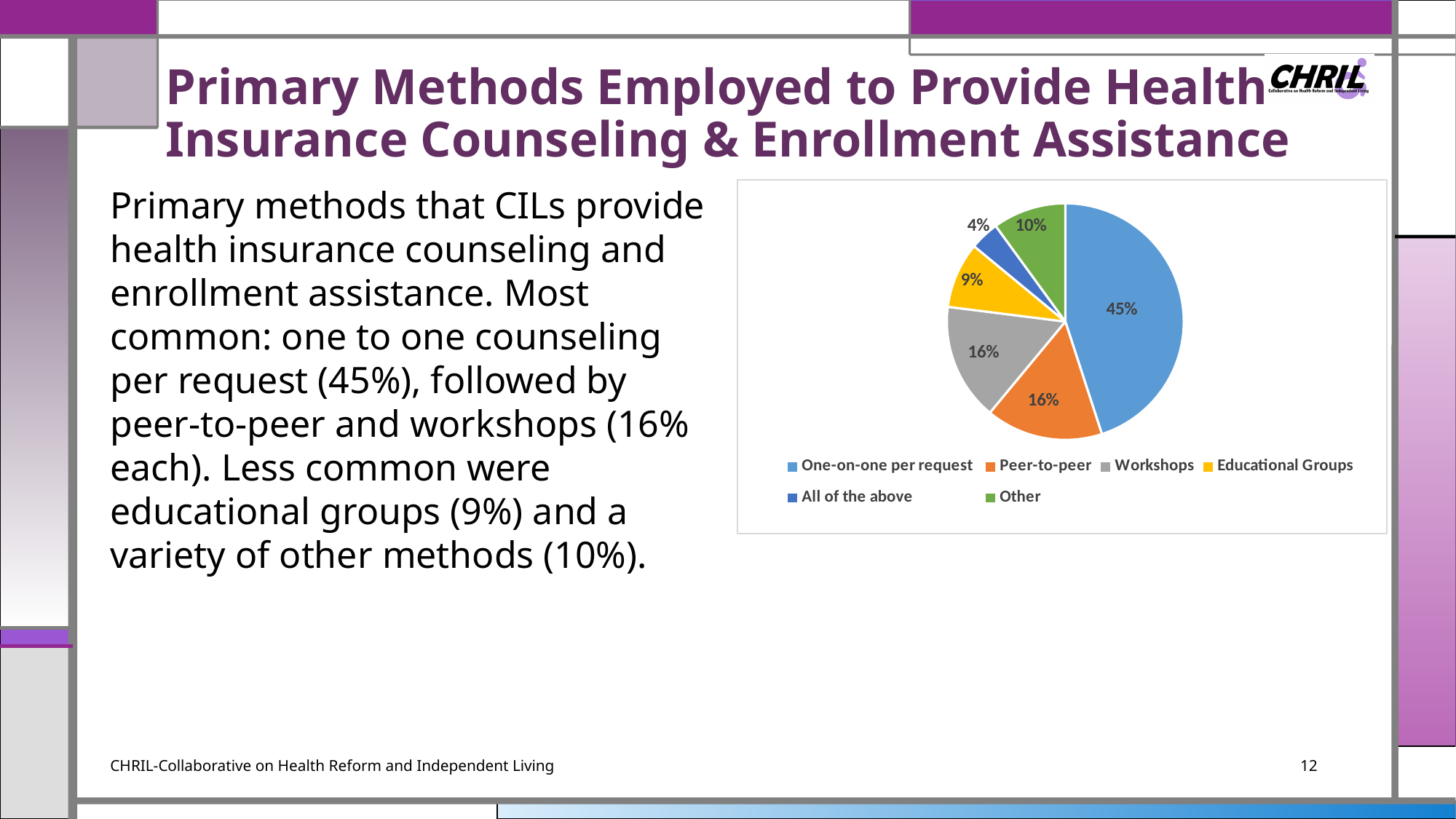
What type of chart is shown on the slide? Pie chart What percentage is shown for All of the above? 4% What percentage is shown for Other? 10% What share of the pie does One-on-one per request represent? 45% Which category has the largest slice of the pie? One-on-one per request What percentage is shown for Peer-to-peer? 16% What is the difference in percentage points between One-on-one per request and Workshops? 29 How many categories does the pie chart have? 6 Which category has the smallest slice of the pie? All of the above What percentage is shown for Educational Groups? 9% Which is larger, the share for Other or the share for Educational Groups? Other What colour is the slice for Workshops? Gray